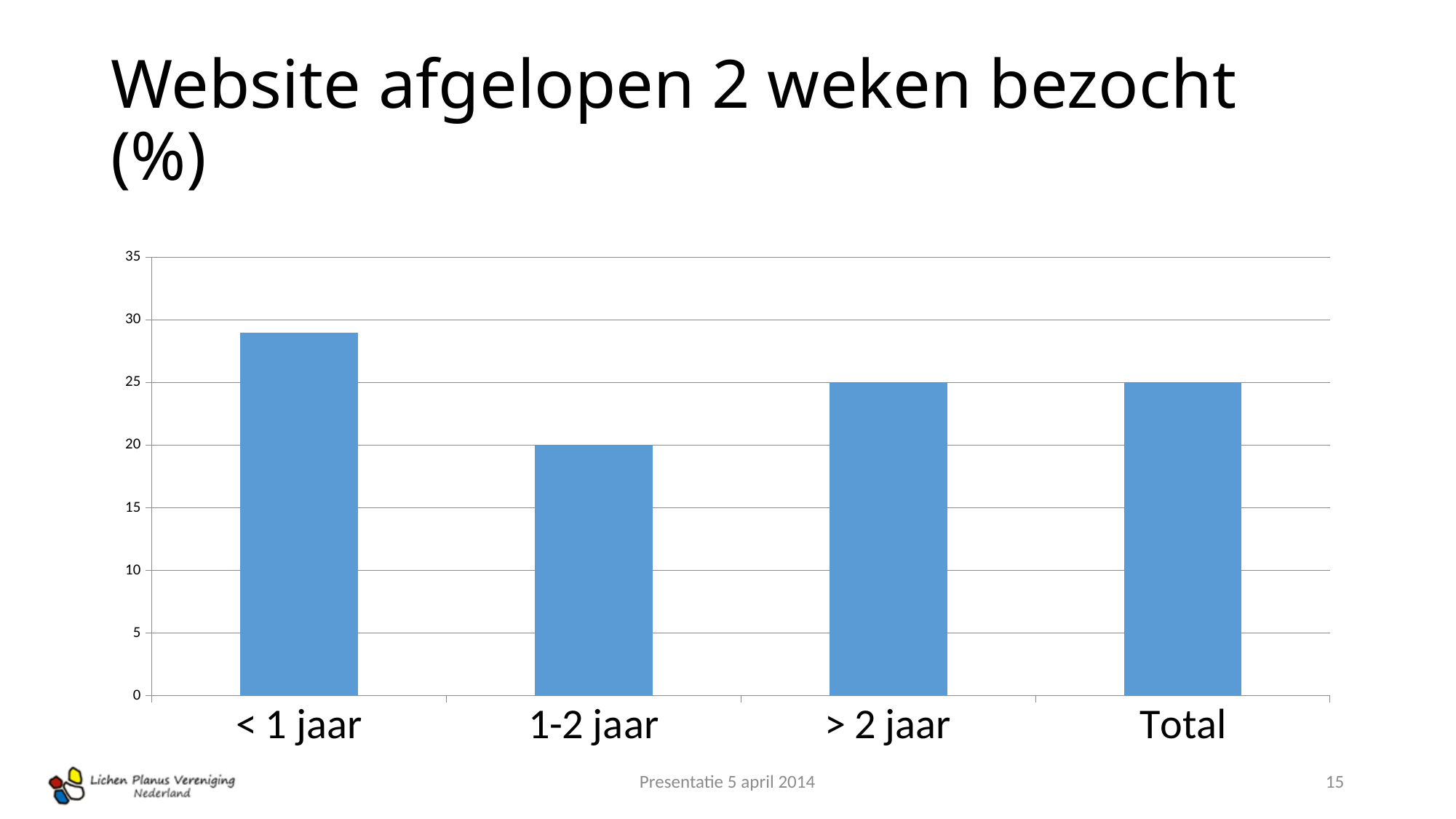
What is the value for 1-2 jaar? 20 Which category has the highest value? < 1 jaar What is the value for Total? 25 Is the value for 1-2 jaar greater or less than 25? less How many categories are shown on the x axis? 4 What is the difference between the value for > 2 jaar and the value for 1-2 jaar? 5 What is the title of the slide? Website afgelopen 2 weken bezocht (%) Which is larger, the value for < 1 jaar or the value for 1-2 jaar? < 1 jaar Which category has the lowest value? 1-2 jaar What kind of chart is shown on the slide? bar chart Is the value for < 1 jaar greater or less than 25? greater What is the value for > 2 jaar? 25